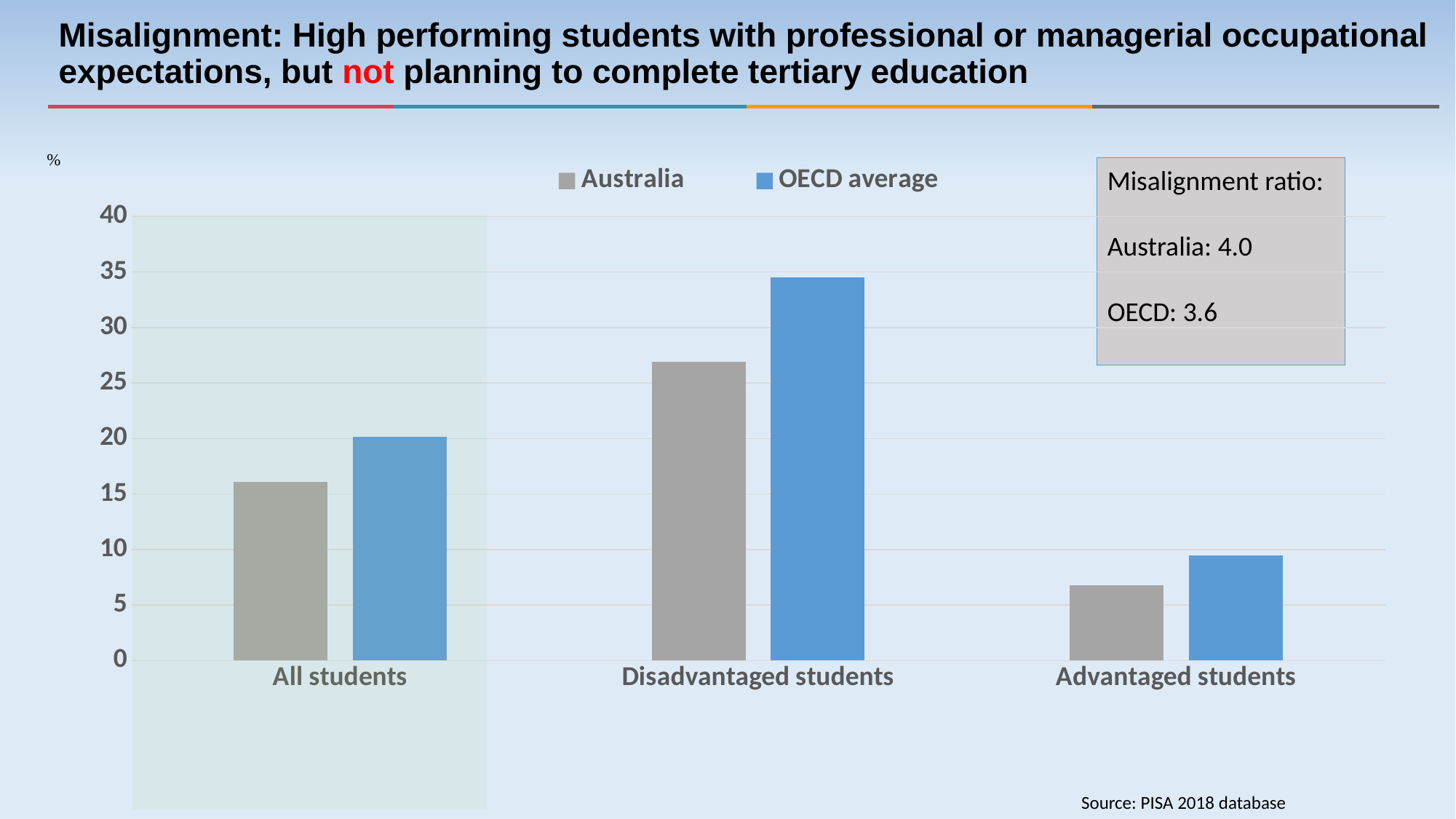
Is the Australia value for Disadvantaged students greater or less than 25? greater Which series does the legend list alongside Australia? OECD average What kind of chart is shown on the slide? bar chart Is the OECD average value for Disadvantaged students greater or less than 30? greater How many series does the legend list? 2 Which category has the lowest Australia bar? Advantaged students For All students, which is larger: the Australia value or the OECD average value? OECD average Is the Australia value for Advantaged students greater or less than 10? less For Disadvantaged students, which is larger: the Australia value or the OECD average value? OECD average How many student categories are shown on the x axis? 3 Which category has the highest OECD average bar? Disadvantaged students What misalignment ratio does the text box give for Australia? 4.0